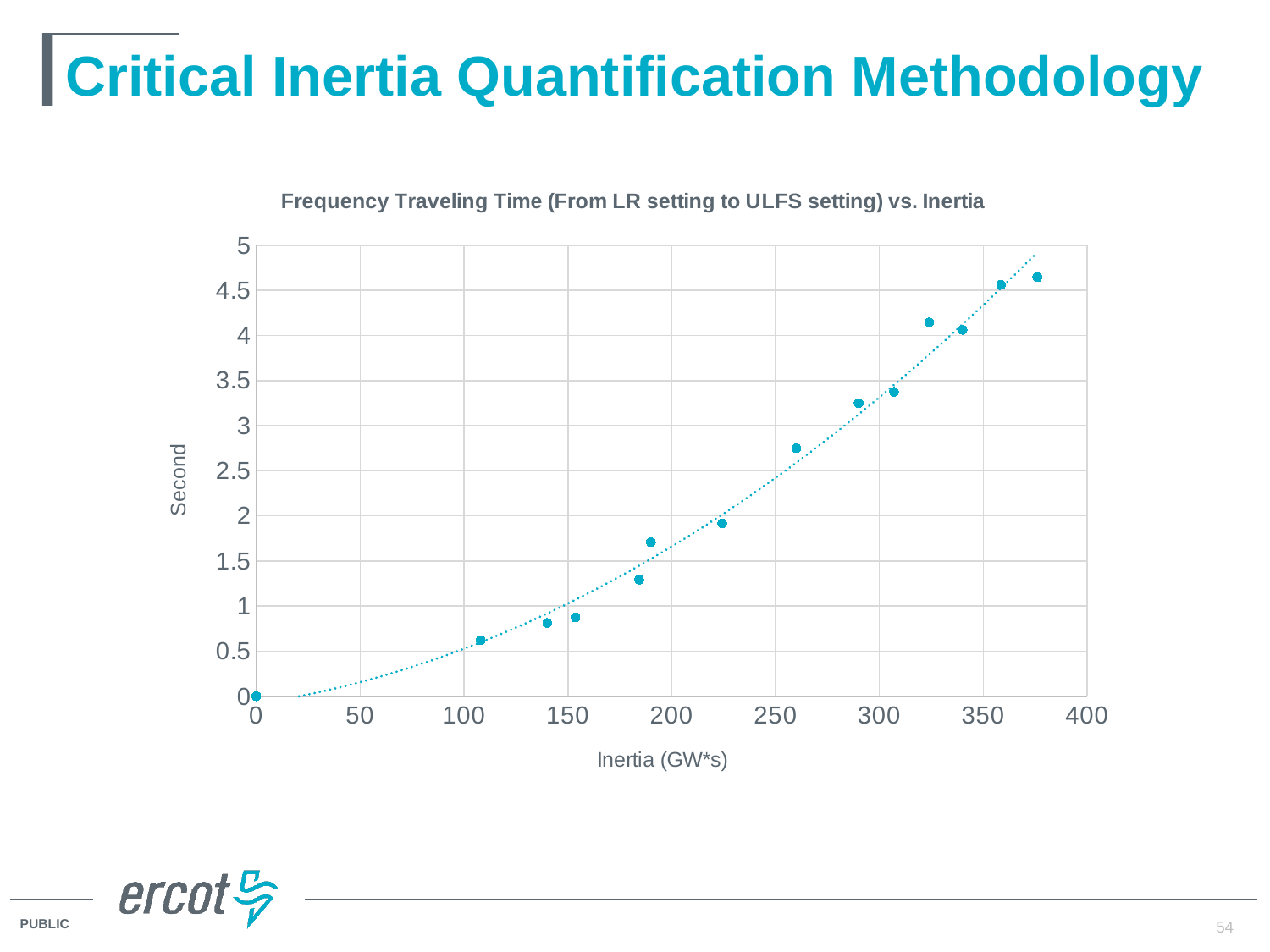
How many data points are plotted on the chart? 14 Is the traveling time for the data point at roughly 225 GW*s of inertia greater or less than 2 seconds? less What is the label of the x axis of the chart? Inertia (GW*s) What kind of chart is shown on the slide? Scatter chart Do the plotted values rise or fall as inertia increases along the x axis? Rise What is the traveling time in seconds for the data point at an inertia of 0 GW*s? 0 What is the title of the chart? Frequency Traveling Time (From LR setting to ULFS setting) vs. Inertia Is the traveling time for the data point at roughly 260 GW*s of inertia greater or less than 2.5 seconds? greater Which has the larger traveling time: the data point near 290 GW*s or the data point near 190 GW*s? The point near 290 GW*s What is the maximum value shown on the y axis (Second) of the chart? 5 Is the traveling time for the data point at roughly 108 GW*s of inertia greater or less than 1 second? less